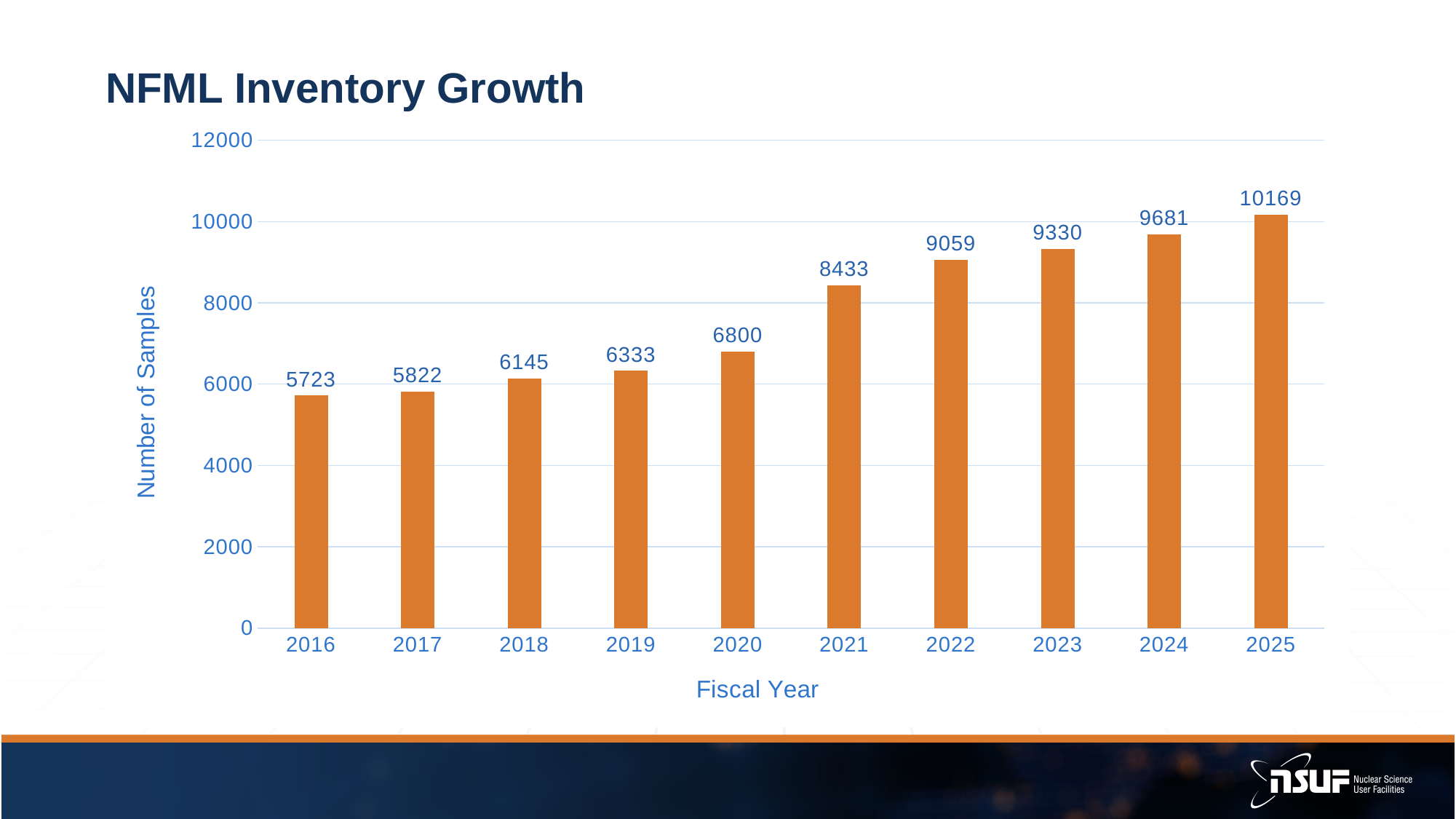
Which fiscal year has the highest number of samples? 2025 How many fiscal years are shown on the chart? 10 Do the values rise or fall from 2016 to 2025? rise What is the difference in number of samples between 2025 and 2016? 4446 Is the value for 2024 greater or less than 10000? less What kind of chart is shown on the slide? bar chart What is the number of samples for fiscal year 2020? 6800 What is the title of the chart? NFML Inventory Growth Which fiscal year has more samples, 2019 or 2022? 2022 What is the number of samples for fiscal year 2023? 9330 What is the difference in number of samples between 2021 and 2020? 1633 Which fiscal year has the lowest number of samples? 2016